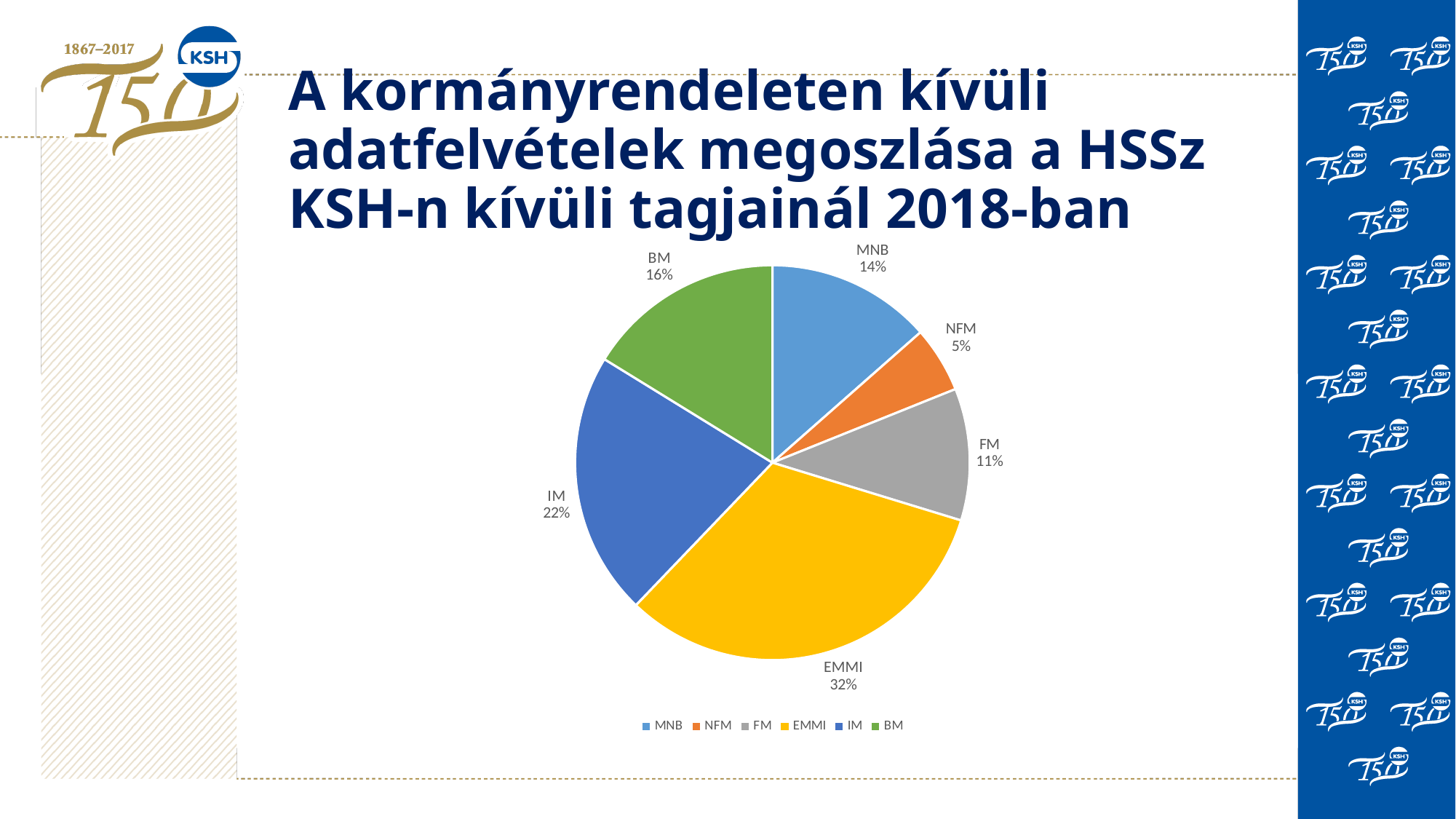
What is the value shown for NFM? 5% Which is larger, the share for MNB or the share for FM? MNB Which category has the smallest slice of the pie? NFM What share of the pie does EMMI have? 32% What is the value shown for BM? 16% Which category has the largest slice of the pie? EMMI How many slices does the pie chart have? 6 What is the difference in percentage points between EMMI and IM? 10 What kind of chart is shown on the slide? pie chart What colour is the EMMI slice? yellow What is the value shown for IM? 22% How many entries does the legend list? 6